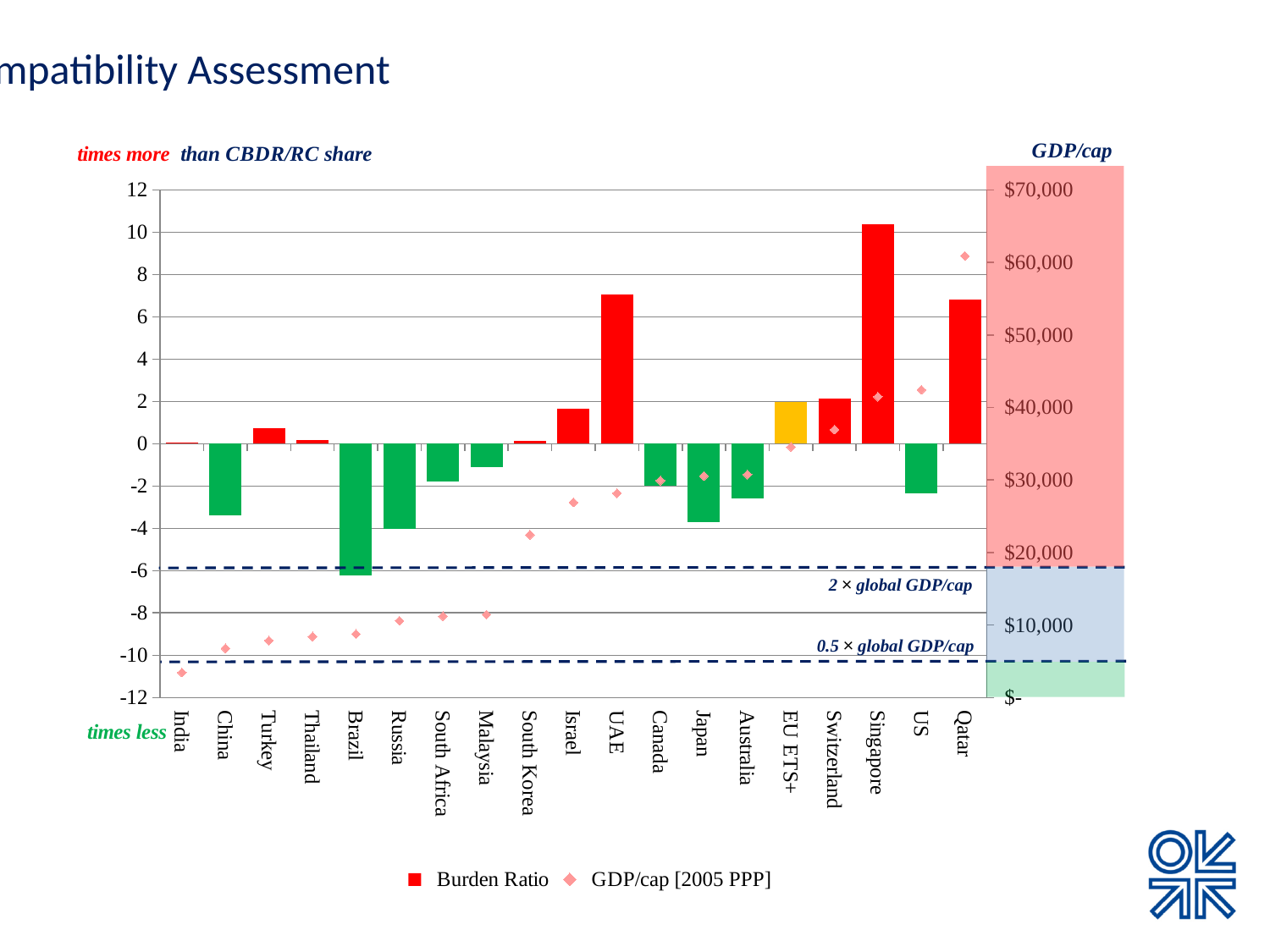
What colour is the Burden Ratio bar for EU ETS+? yellow Is the Burden Ratio for Brazil greater or less than -4? less Which has the larger Burden Ratio, Singapore or Qatar? Singapore Is the Burden Ratio for UAE greater or less than 6? greater Is the GDP/cap for the US greater or less than $40,000? greater Which country has the highest GDP/cap marker? Qatar How many series does the chart legend list? 2 How many countries or regions are shown along the x axis of the chart? 19 Which country has the lowest (most negative) Burden Ratio bar? Brazil What are the two series named in the chart legend? Burden Ratio and GDP/cap [2005 PPP] Which country has the highest Burden Ratio bar? Singapore